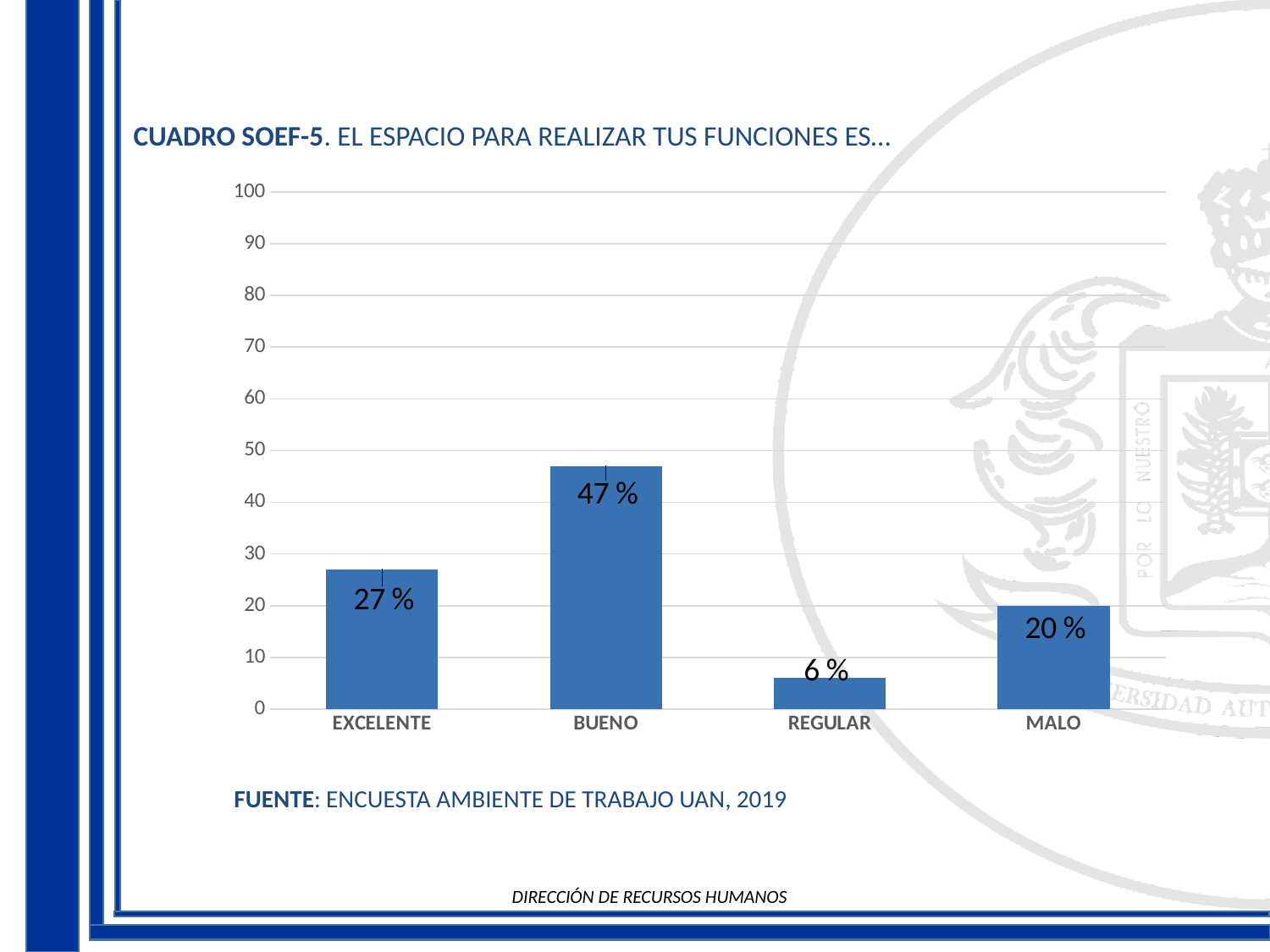
What is the difference between the values for BUENO and EXCELENTE? 20 % What is the difference between the values for MALO and REGULAR? 14 % Which category has the highest value? BUENO What kind of chart is shown on the slide? bar chart What is the value for BUENO? 47 % Is the value for BUENO greater or less than 40? greater Which category has the lowest value? REGULAR Which is larger, the value for EXCELENTE or the value for MALO? EXCELENTE What is the value for REGULAR? 6 % How many categories are shown on the x axis? 4 What is the value for EXCELENTE? 27 % What is the value for MALO? 20 %